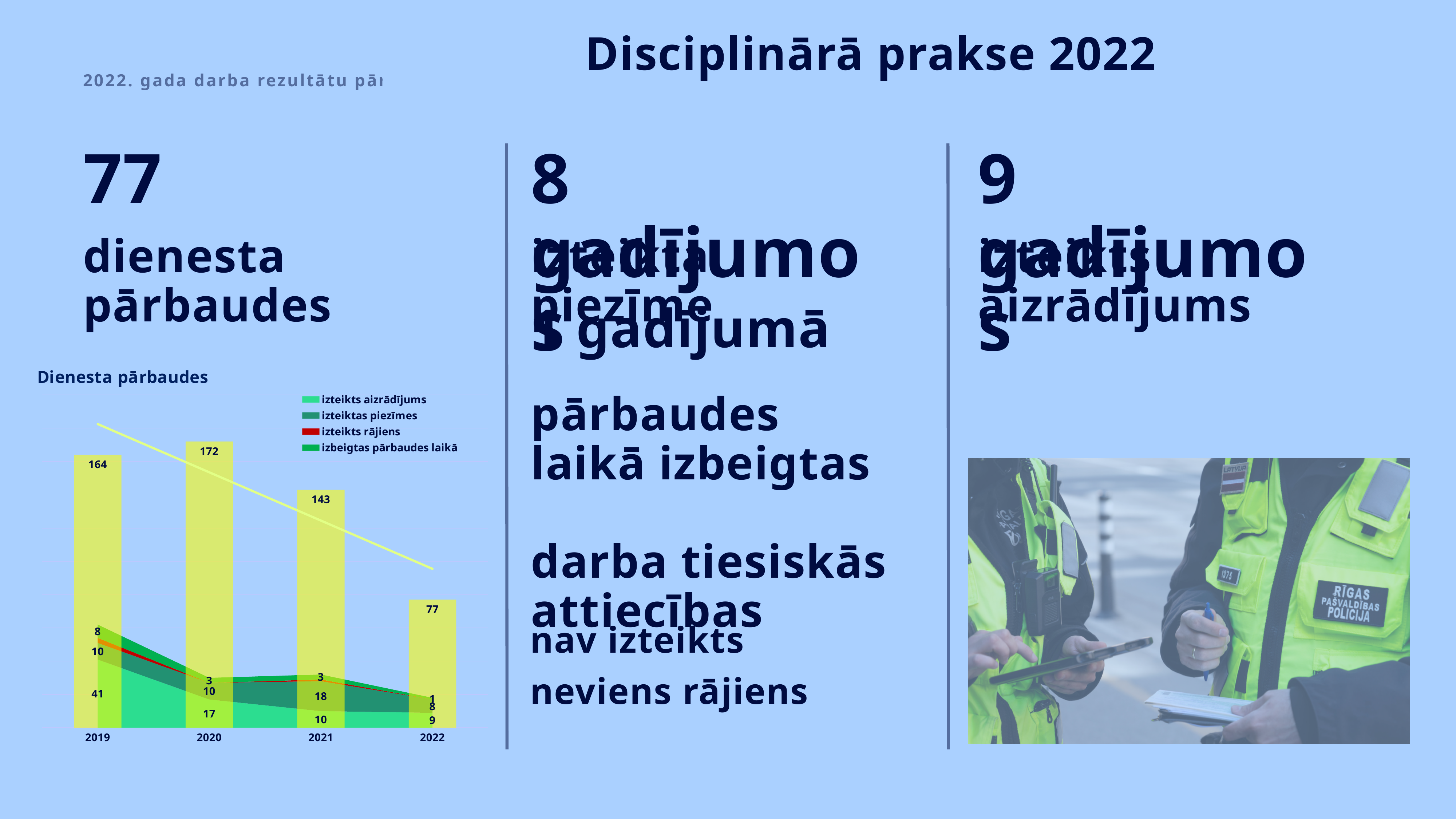
In the 'Dienesta pārbaudes' chart, what is the value of the yellow bar for 2022? 77 How many years are shown on the x axis of the 'Dienesta pārbaudes' chart? 4 In the 'Dienesta pārbaudes' chart, which year has the lowest yellow bar? 2022 In the 'Dienesta pārbaudes' chart, which year has the highest yellow bar? 2020 How many series does the legend of the 'Dienesta pārbaudes' chart list? 4 In the 'Dienesta pārbaudes' chart, what is the difference between the yellow bar values for 2019 and 2022? 87 In the 'Dienesta pārbaudes' chart, what is the value of the yellow bar for 2019? 164 In the 'Dienesta pārbaudes' chart, is the yellow bar for 2021 larger or smaller than the yellow bar for 2019? smaller In the 'Dienesta pārbaudes' chart, what is the value of the yellow bar for 2021? 143 In the 'Dienesta pārbaudes' chart, what is the difference between the yellow bar values for 2020 and 2021? 29 In the 'Dienesta pārbaudes' chart, what is the value of the yellow bar for 2020? 172 In the 'Dienesta pārbaudes' chart, do the yellow bar values rise or fall from 2020 to 2022? fall